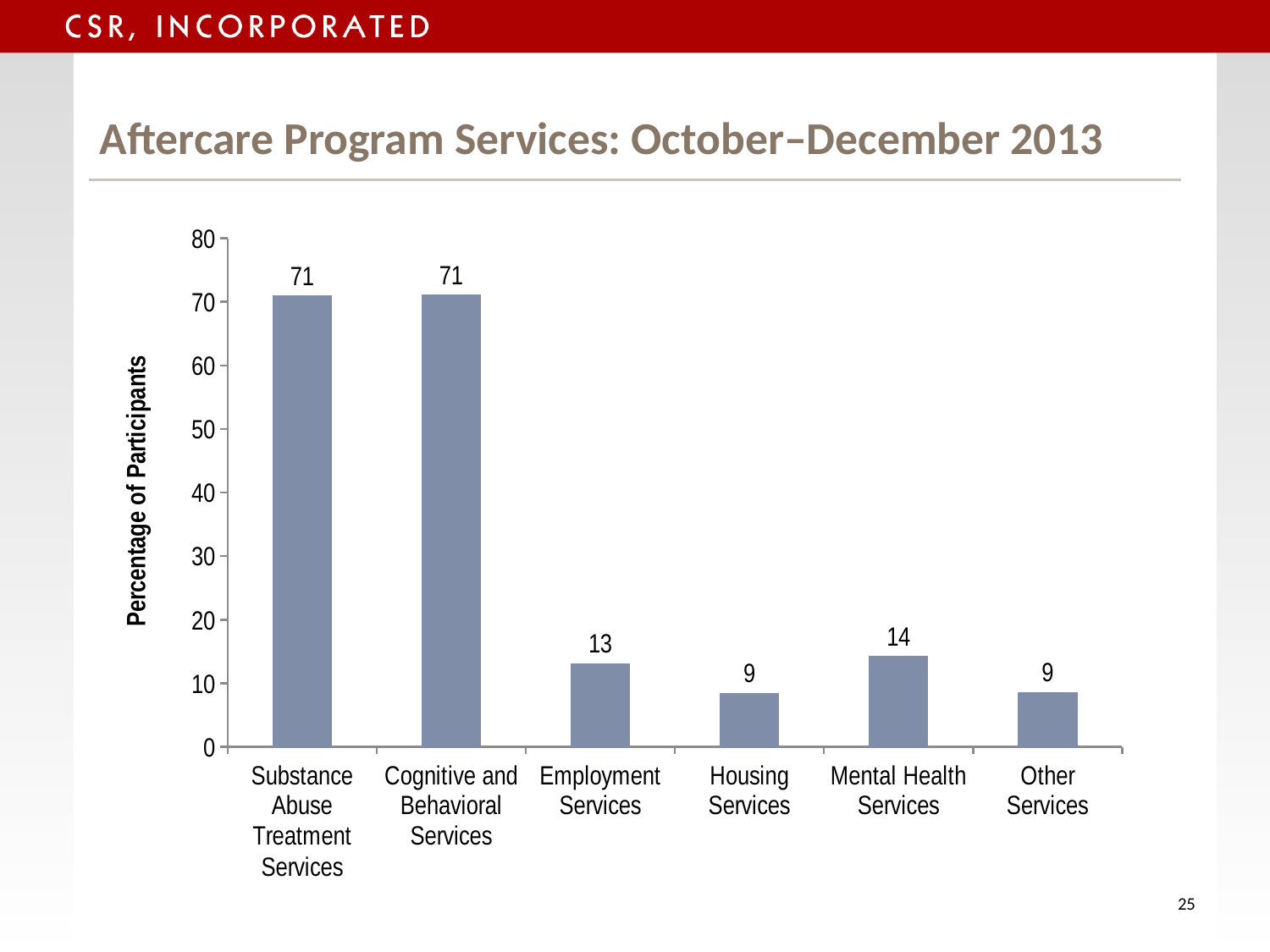
What is the value for Mental Health Services? 14 Which category has the lowest value among Employment Services, Housing Services and Mental Health Services? Housing Services What is the value for Cognitive and Behavioral Services? 71 What is the value for Housing Services? 9 What is the difference between the values for Mental Health Services and Other Services? 5 What is the label of the y axis? Percentage of Participants What is the value for Employment Services? 13 What kind of chart is shown on the slide? bar chart Which is larger, the value for Mental Health Services or the value for Employment Services? Mental Health Services How many categories are shown on the x axis? 6 Is the value for Substance Abuse Treatment Services greater or less than 60? greater What is the difference between the values for Substance Abuse Treatment Services and Employment Services? 58